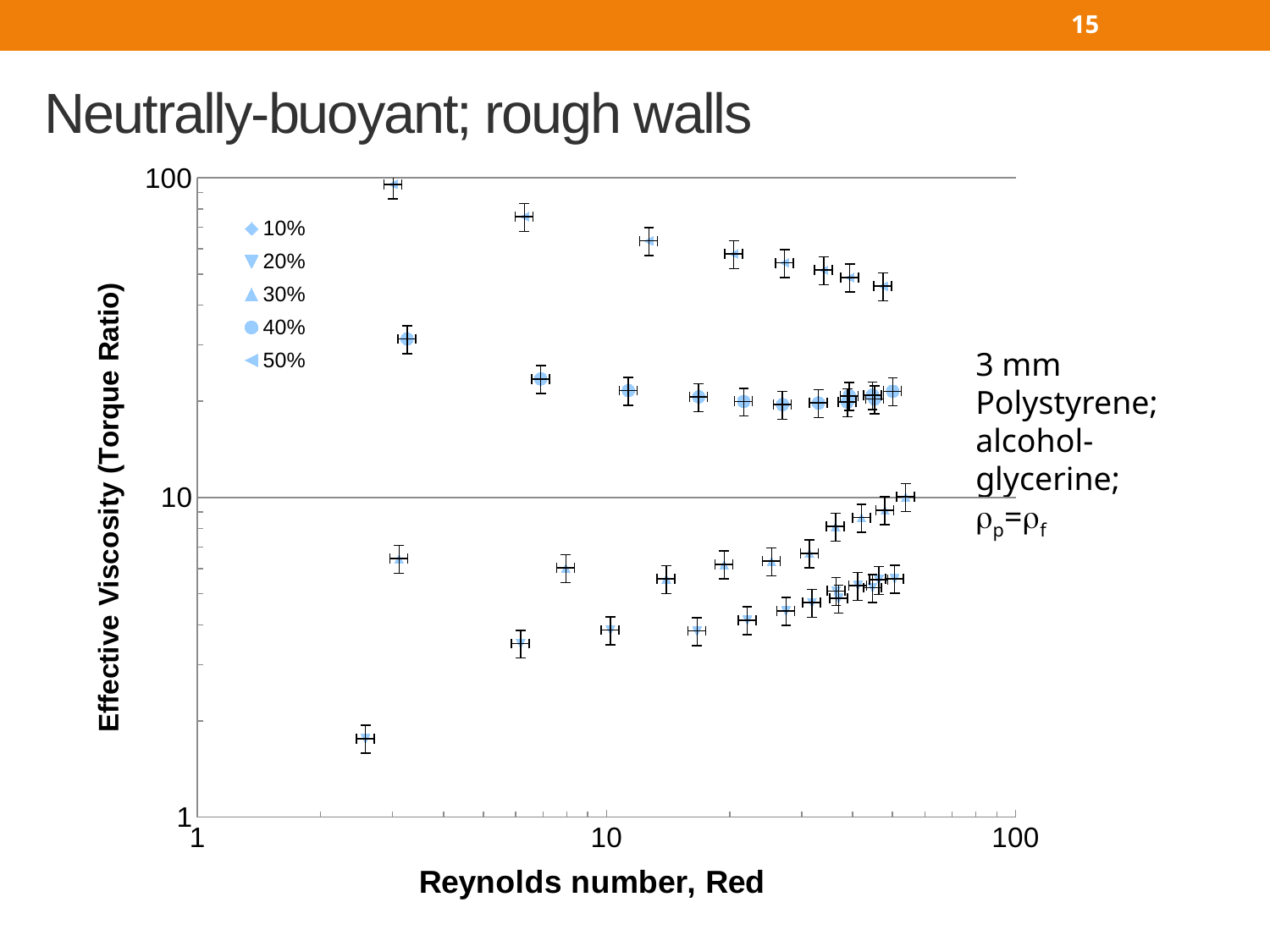
How many series does the legend list? 5 Does the uppermost band of points rise or fall as the Reynolds number increases? fall What is the title of the x axis? Reynolds number, Red What is the title of the y axis? Effective Viscosity (Torque Ratio) Does the lowest band of points rise or fall as the Reynolds number increases beyond 10? rise Is the highest plotted point's Reynolds number greater or less than 10? less What kind of chart is shown on the slide? scatter chart Is the lowest plotted effective viscosity value greater or less than 10? less Is the lowest plotted point's Reynolds number greater or less than 10? less